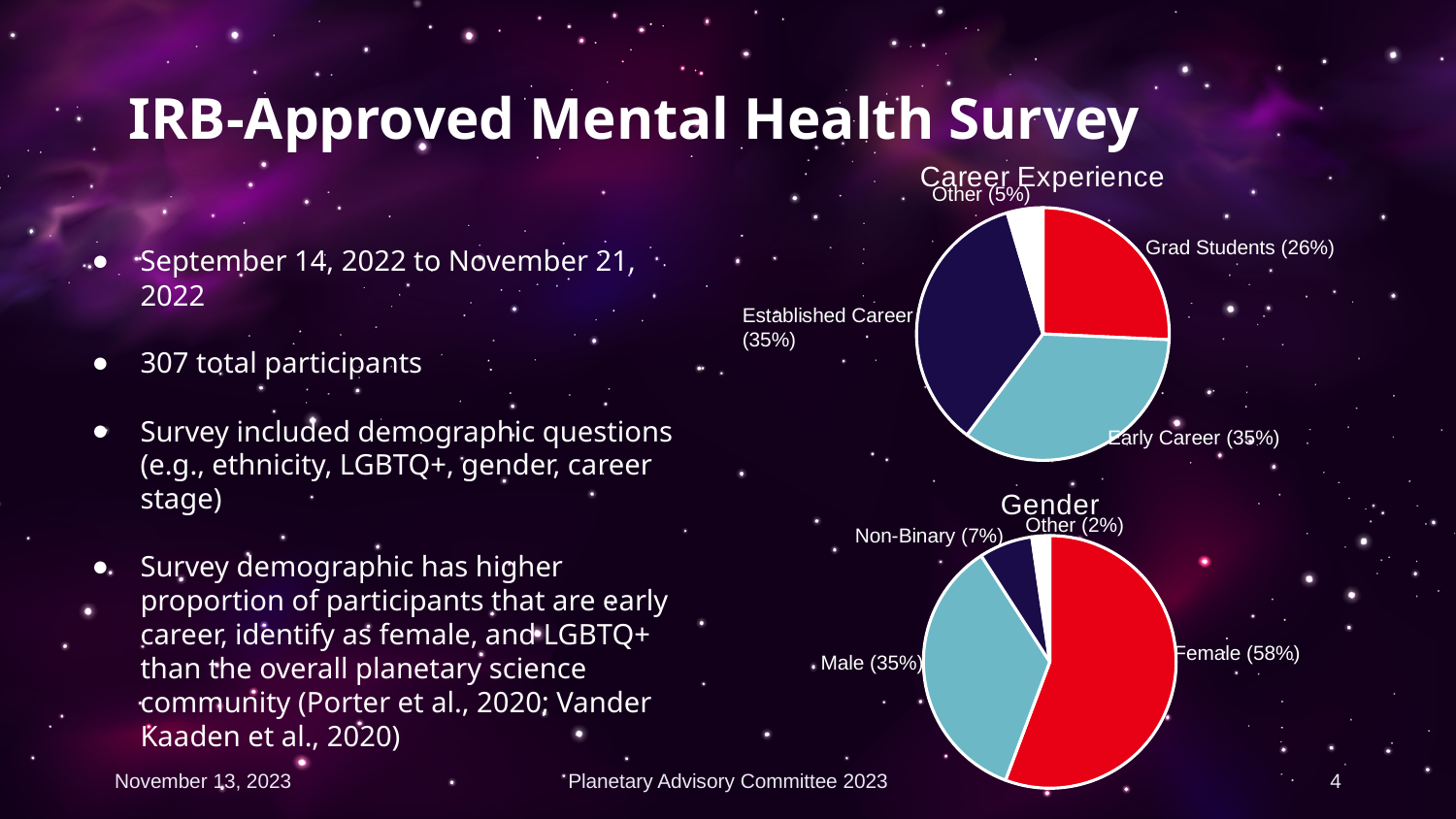
In the Career Experience chart, what share of participants are Grad Students? 26% In the Gender chart, which category has the smallest share? Other In the Gender chart, which category has the largest share? Female In the Career Experience chart, how many categories are shown? 4 In the Gender chart, what share of participants identify as Female? 58% What type of chart is the Gender chart? Pie chart In the Gender chart, what is the difference between the Female share and the Male share? 23% In the Gender chart, which is larger, the Male share or the Non-Binary share? Male In the Career Experience chart, what is the difference between the Early Career share and the Grad Students share? 9% In the Career Experience chart, which category has the smallest share? Other In the Gender chart, what share of participants identify as Non-Binary? 7% In the Career Experience chart, what share of participants are in the Established Career category? 35%